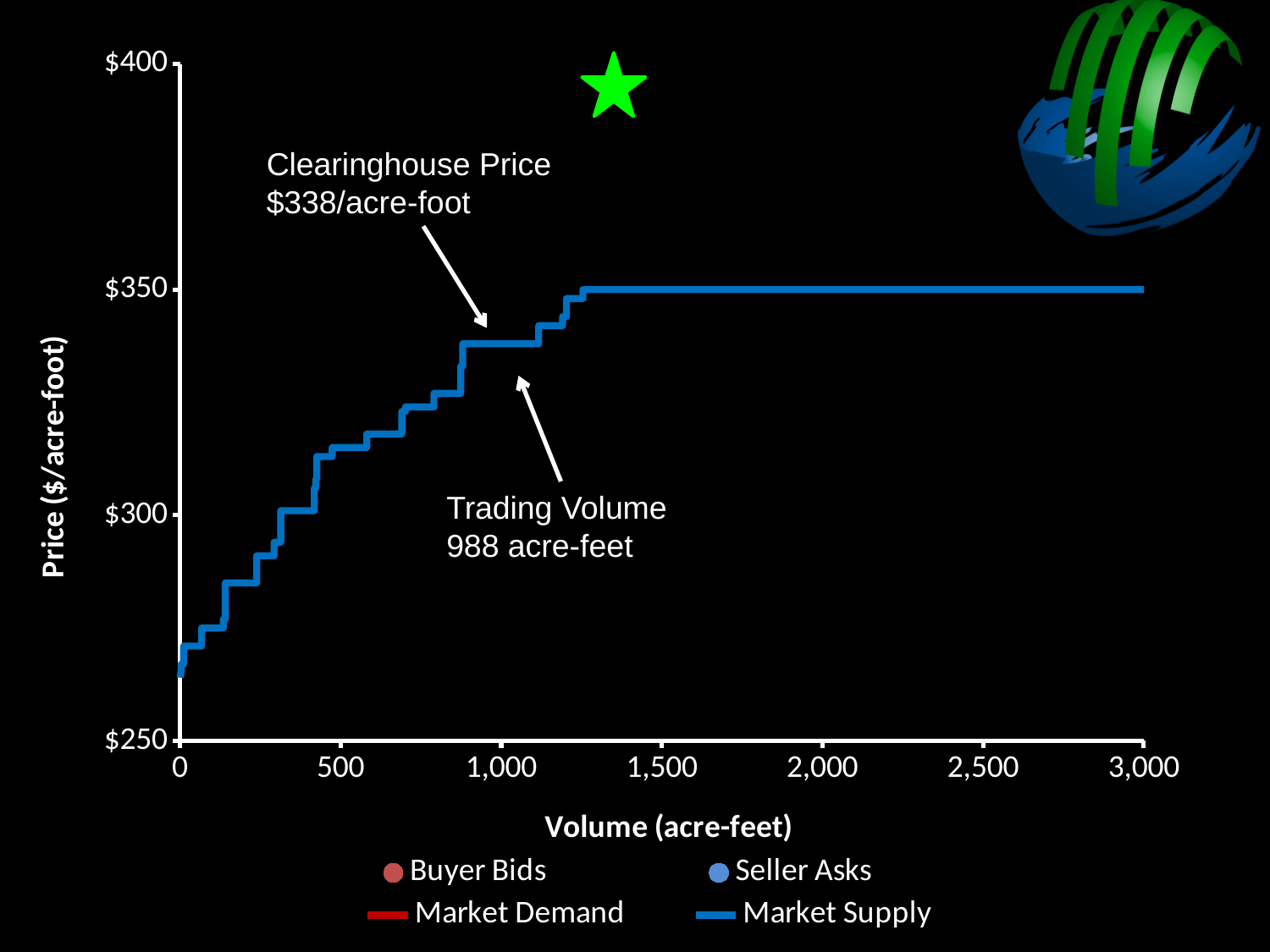
What is the label of the y axis? Price ($/acre-foot) Is the Market Supply price at a volume of 2,500 acre-feet greater or less than $400? less How many series does the legend list? 4 What is the Clearinghouse Price annotated on the chart? $338/acre-foot What is the Trading Volume annotated on the chart? 988 acre-feet Is the Market Supply price at a volume of 0 acre-feet greater or less than $300? less Is the Market Supply price at a volume of 2,000 acre-feet greater or less than $300? greater What colour is the Market Supply line in the legend? blue Does the Market Supply curve rise or fall as volume increases from 0 to 1,000 acre-feet? rise What is the highest price the Market Supply curve reaches? $350 What kind of chart is shown on the slide? line chart